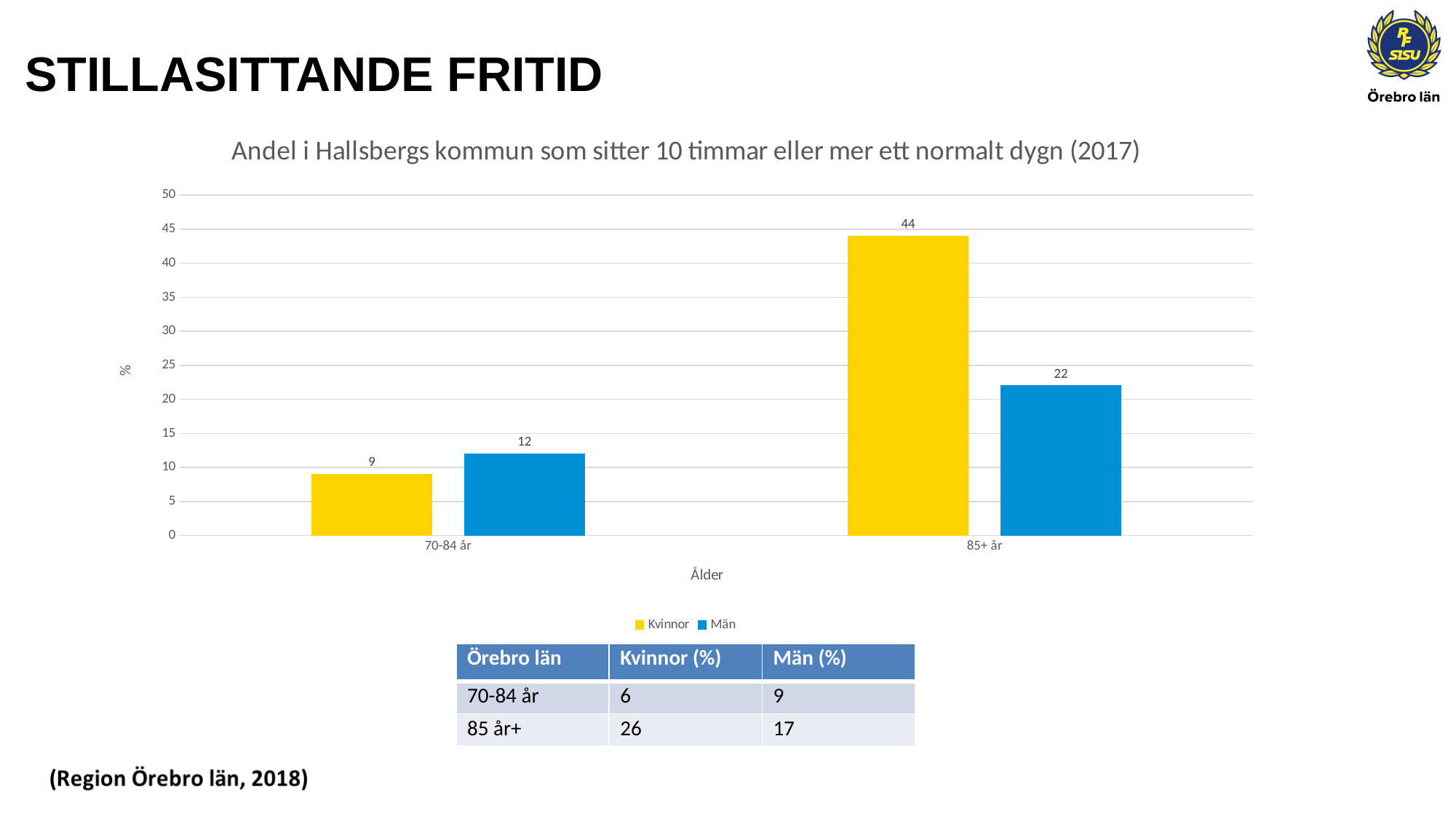
What colour represents Kvinnor in the chart? Yellow Which bar has the highest value in the chart? Kvinnor, 85+ år In the 70-84 år category, which is larger, Kvinnor or Män? Män What kind of chart is shown on the slide? Bar chart What is the value for Män in the 70-84 år category? 12 What is the difference between the Kvinnor and Män values in the 85+ år category? 22 How many age categories are shown on the x axis? 2 What is the value for Män in the 85+ år category? 22 What is the value for Kvinnor in the 70-84 år category? 9 Which bar has the lowest value in the chart? Kvinnor, 70-84 år What is the value for Kvinnor in the 85+ år category? 44 How many series does the legend list? 2